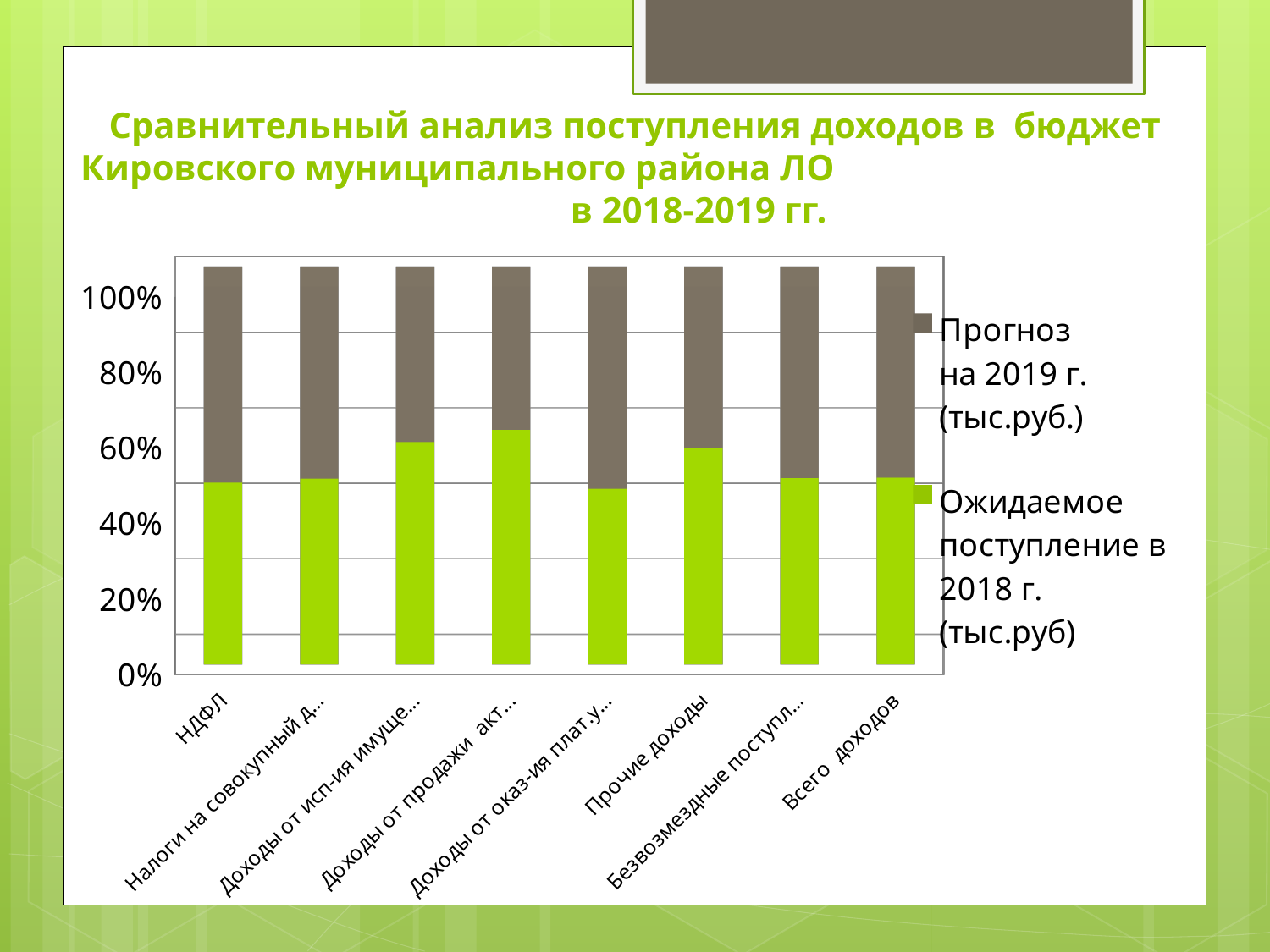
Which series is shown in green in the chart? Ожидаемое поступление в 2018 г. (тыс.руб) Is the share of 'Ожидаемое поступление в 2018 г.' for НДФЛ greater or less than 40%? greater How many series does the chart legend list? 2 What kind of chart is shown on the slide? stacked bar chart Which series is shown in grey in the chart? Прогноз на 2019 г. (тыс.руб.) Which has the larger share of 'Ожидаемое поступление в 2018 г.': НДФЛ or Прочие доходы? Прочие доходы Which has the larger share of 'Прогноз на 2019 г.': НДФЛ or Прочие доходы? НДФЛ How many categories are shown along the x axis of the chart? 8 What is the highest percentage label shown on the y axis of the chart? 100% Is the share of 'Ожидаемое поступление в 2018 г.' for НДФЛ greater or less than 60%? less Is the share of 'Ожидаемое поступление в 2018 г.' for Прочие доходы greater or less than 40%? greater